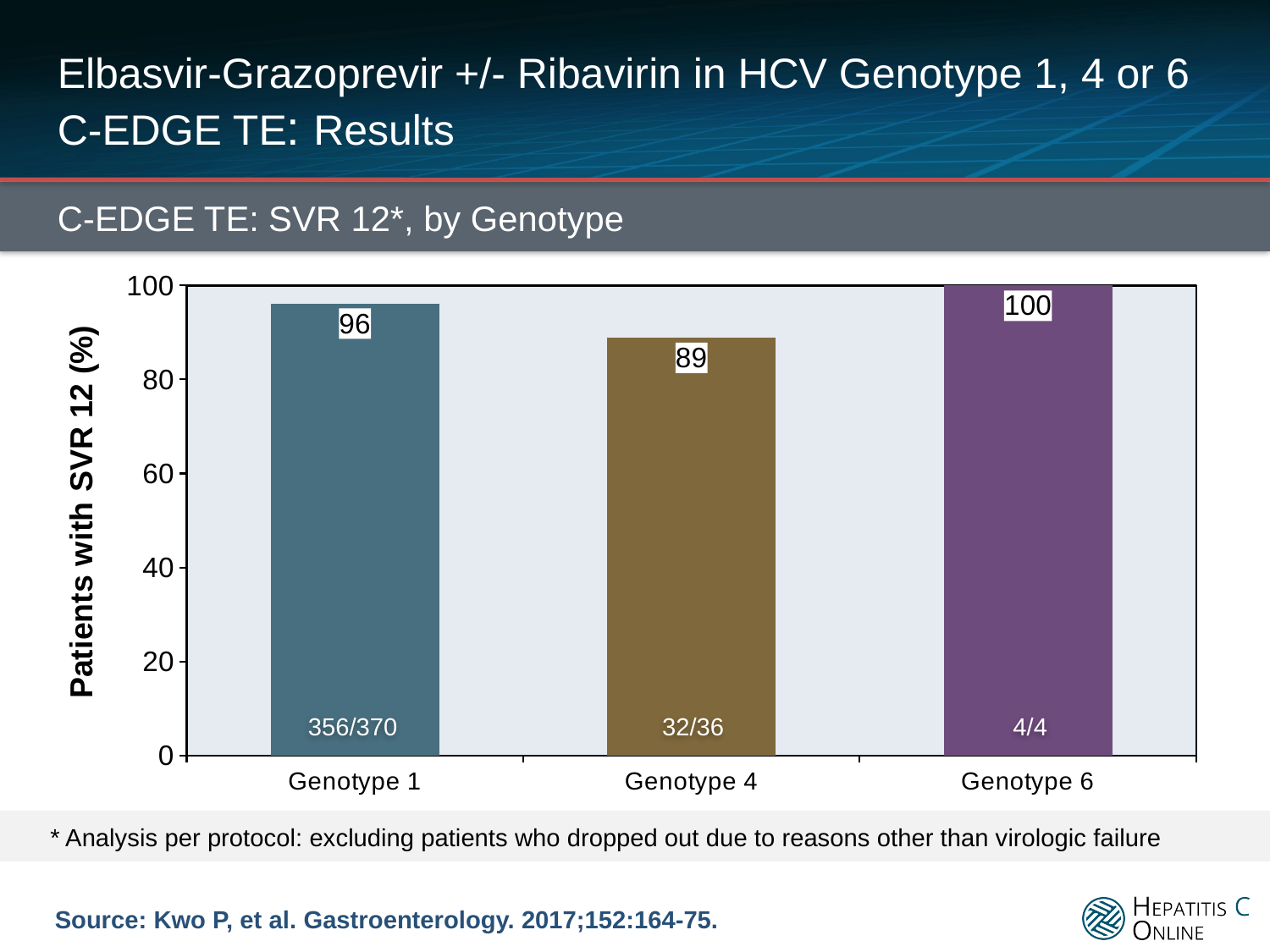
What is the SVR 12 value for Genotype 1? 96 What is the title of the chart? C-EDGE TE: SVR 12*, by Genotype How many genotype categories are shown in the chart? 3 Is the SVR 12 value for Genotype 4 greater or less than 80? greater What fraction of patients is shown inside the Genotype 1 bar? 356/370 Which genotype has the highest SVR 12 rate? Genotype 6 Which has a higher SVR 12 rate, Genotype 1 or Genotype 4? Genotype 1 What kind of chart is shown on the slide? Bar chart What is the SVR 12 value for Genotype 6? 100 Which genotype has the lowest SVR 12 rate? Genotype 4 What is the difference in SVR 12 between Genotype 1 and Genotype 4? 7 What is the SVR 12 value for Genotype 4? 89